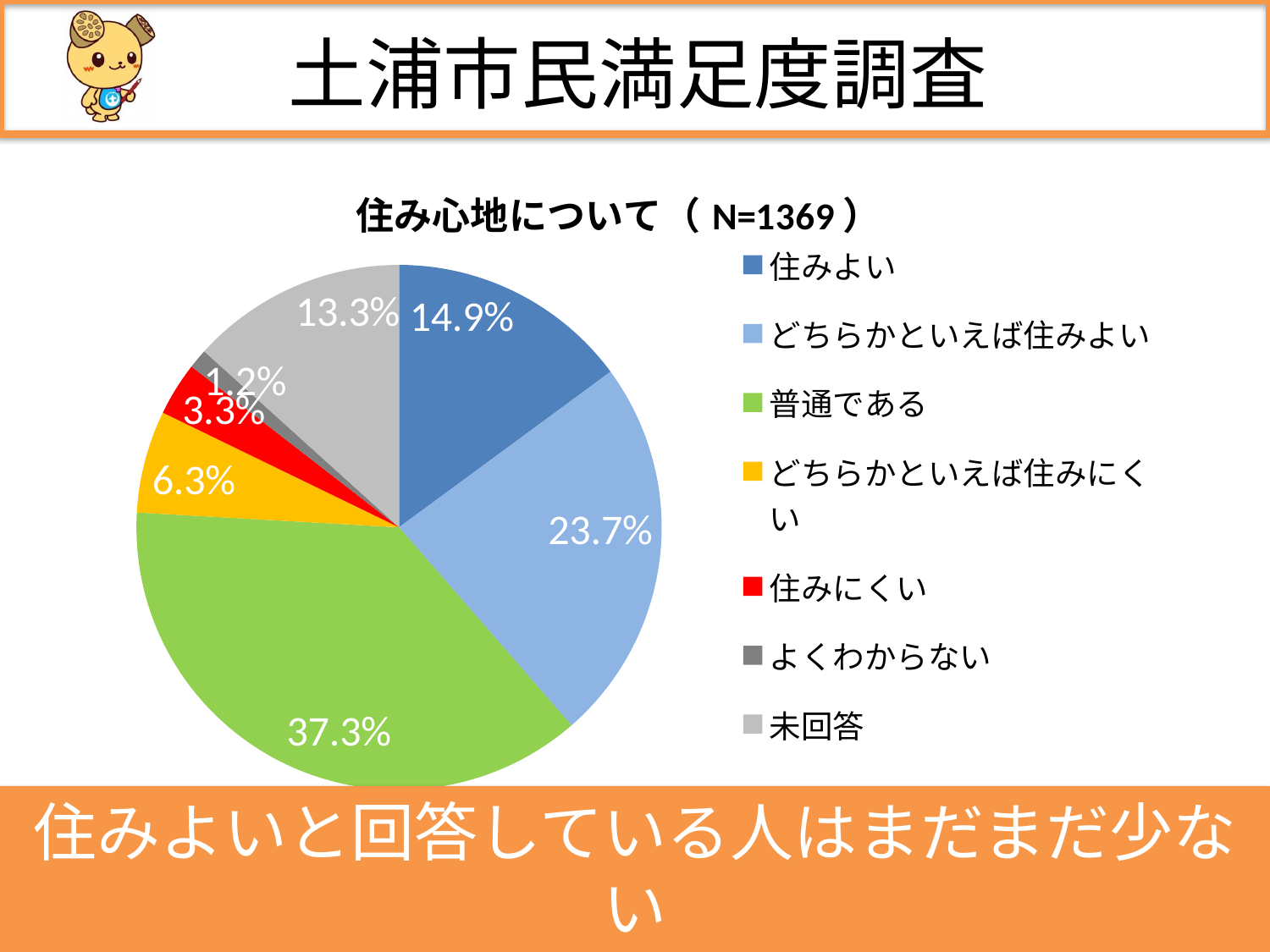
Which category has the smallest share of the pie? よくわからない What percentage is shown for 未回答? 13.3% Which category has the largest share of the pie? 普通である What kind of chart is shown on the slide? pie chart Which is larger, the share for 住みよい or the share for 未回答? 住みよい What percentage of respondents answered 普通である? 37.3% What percentage of respondents answered 住みよい? 14.9% How many categories does the legend list? 7 What is the title of the chart? 住み心地について（N=1369） What is the difference in percentage points between 普通である and どちらかといえば住みよい? 13.6 What percentage of respondents answered 住みにくい? 3.3% What percentage of respondents answered どちらかといえば住みよい? 23.7%